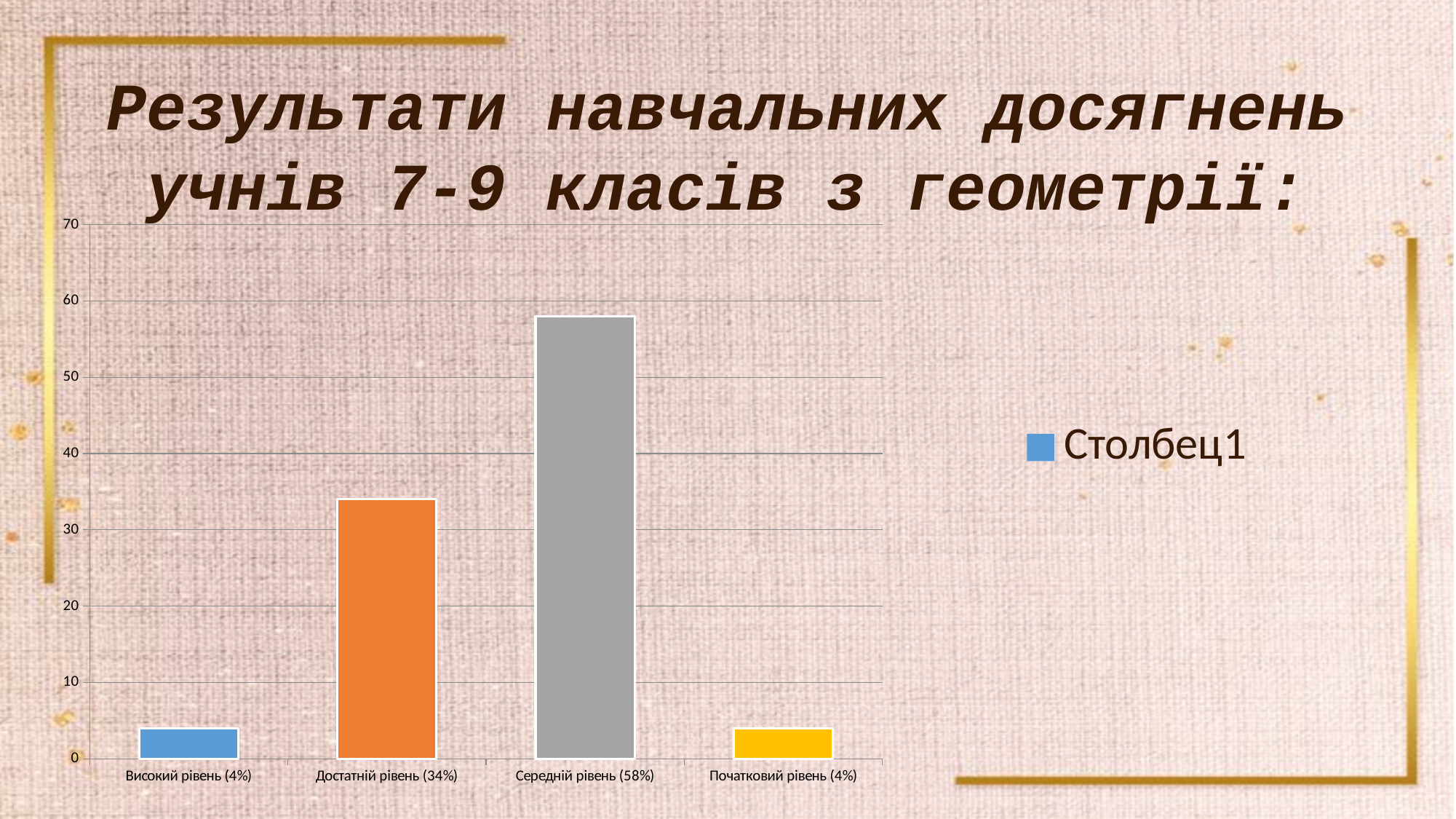
What value is shown for Середній рівень? 58% How many series does the legend list? 1 What is the difference between the values for Середній рівень and Достатній рівень? 24% What value is shown for Достатній рівень? 34% Which is larger, the value for Достатній рівень or the value for Початковий рівень? Достатній рівень What is the legend entry shown on the chart? Столбец1 What value is shown for Високий рівень? 4% Which category has the highest bar? Середній рівень (58%) How many categories are shown on the x axis? 4 Is the value for Достатній рівень greater or less than 40? less Is the value for Середній рівень greater or less than 50? greater What kind of chart is shown on the slide? bar chart